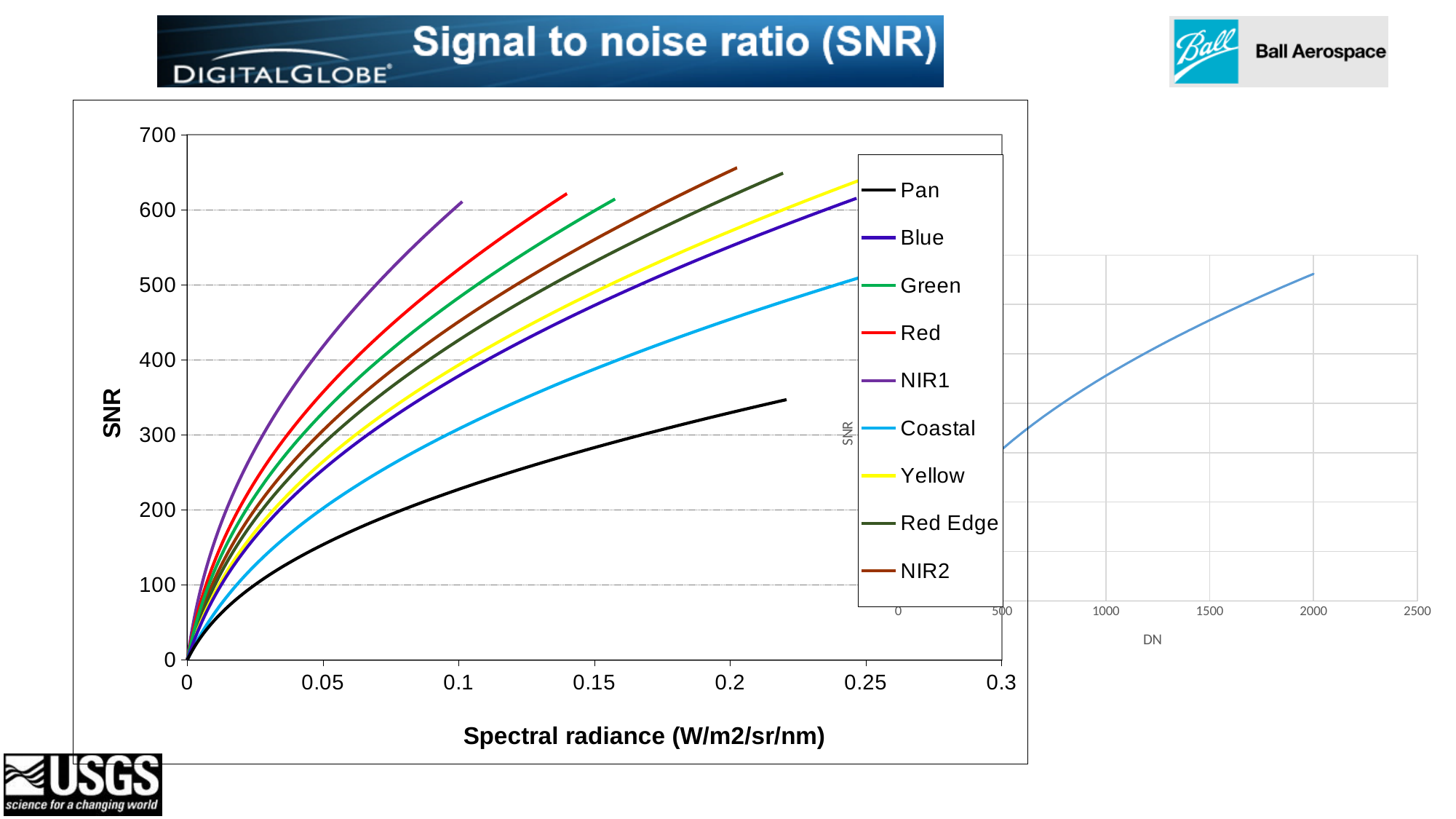
In the main SNR chart, which series has the lowest SNR across the plotted radiance range? Pan In the main SNR chart, do the SNR values rise or fall as spectral radiance increases? rise In the main SNR chart, what colour is the line for the Pan series? black What is the x-axis title of the main SNR chart? Spectral radiance (W/m2/sr/nm) In the main SNR chart, is the SNR of the NIR1 series at a spectral radiance of 0.05 greater or less than 400? greater In the main SNR chart, is the SNR of the Pan series at a spectral radiance of 0.2 greater or less than 300? greater In the main SNR chart, is the SNR of the Coastal series at a spectral radiance of 0.1 greater or less than 400? less In the main SNR chart, at a spectral radiance of 0.2, which series has the larger SNR, Coastal or Pan? Coastal What kind of chart is the main chart on the slide? line chart In the main SNR chart, at a spectral radiance of 0.1, which series has the larger SNR, NIR1 or Pan? NIR1 In the main SNR chart, which series has the highest SNR at a spectral radiance of 0.1? NIR1 How many series does the legend of the main SNR chart list? 9